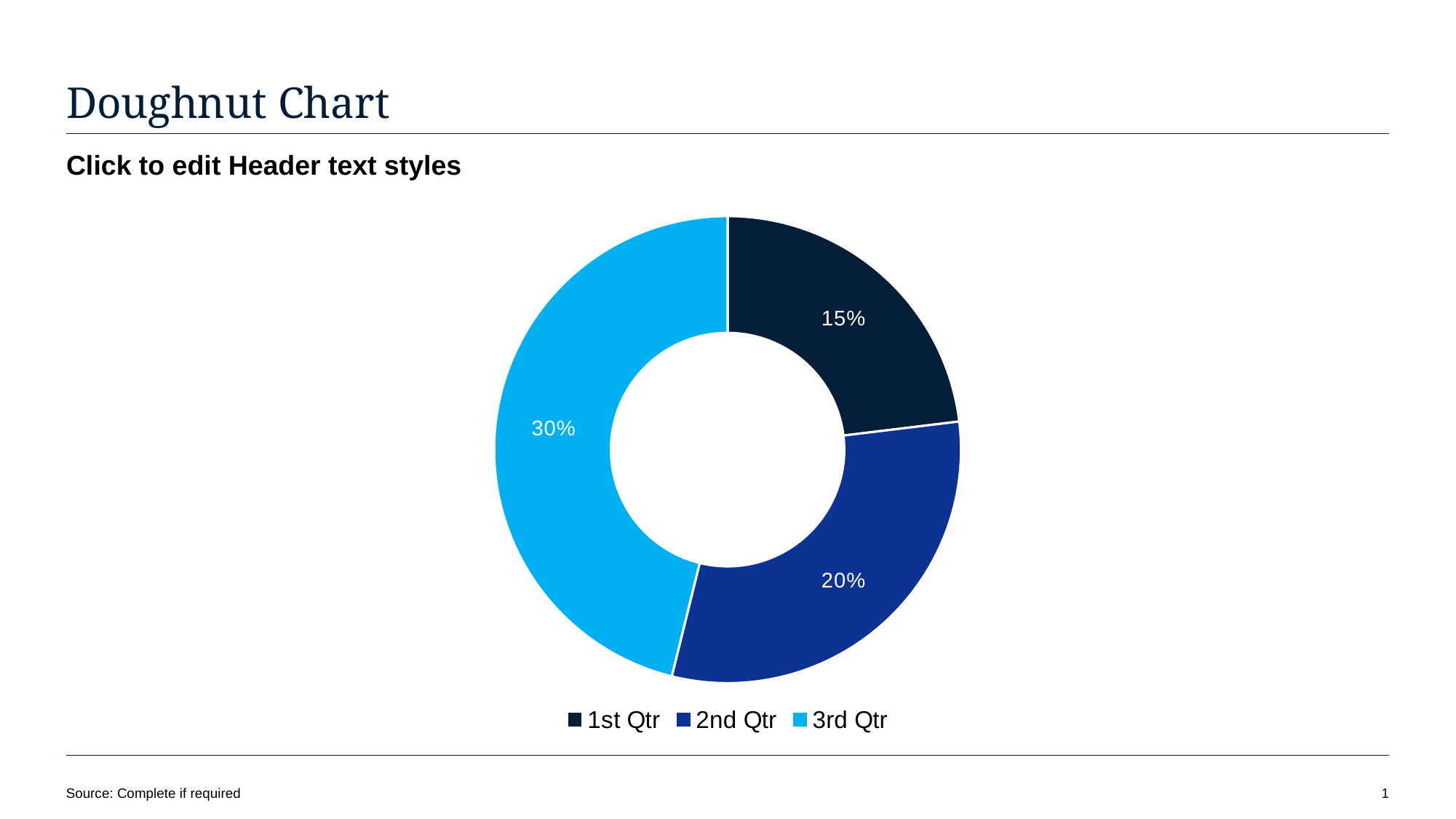
What value is shown for 1st Qtr on the doughnut chart? 15% What is the difference between the values labelled for 3rd Qtr and 1st Qtr? 15% How many slices does the doughnut chart have? 3 Which is larger, the value for 2nd Qtr or the value for 1st Qtr? 2nd Qtr What value is shown for 2nd Qtr on the doughnut chart? 20% Which quarter has the smallest slice in the doughnut chart? 1st Qtr Which quarter has the largest slice in the doughnut chart? 3rd Qtr What are the legend entries of the chart? 1st Qtr, 2nd Qtr, 3rd Qtr What kind of chart is shown on the slide? Doughnut chart What is the title of the slide containing the chart? Doughnut Chart What value is shown for 3rd Qtr on the doughnut chart? 30% What is the difference between the values labelled for 2nd Qtr and 1st Qtr? 5%